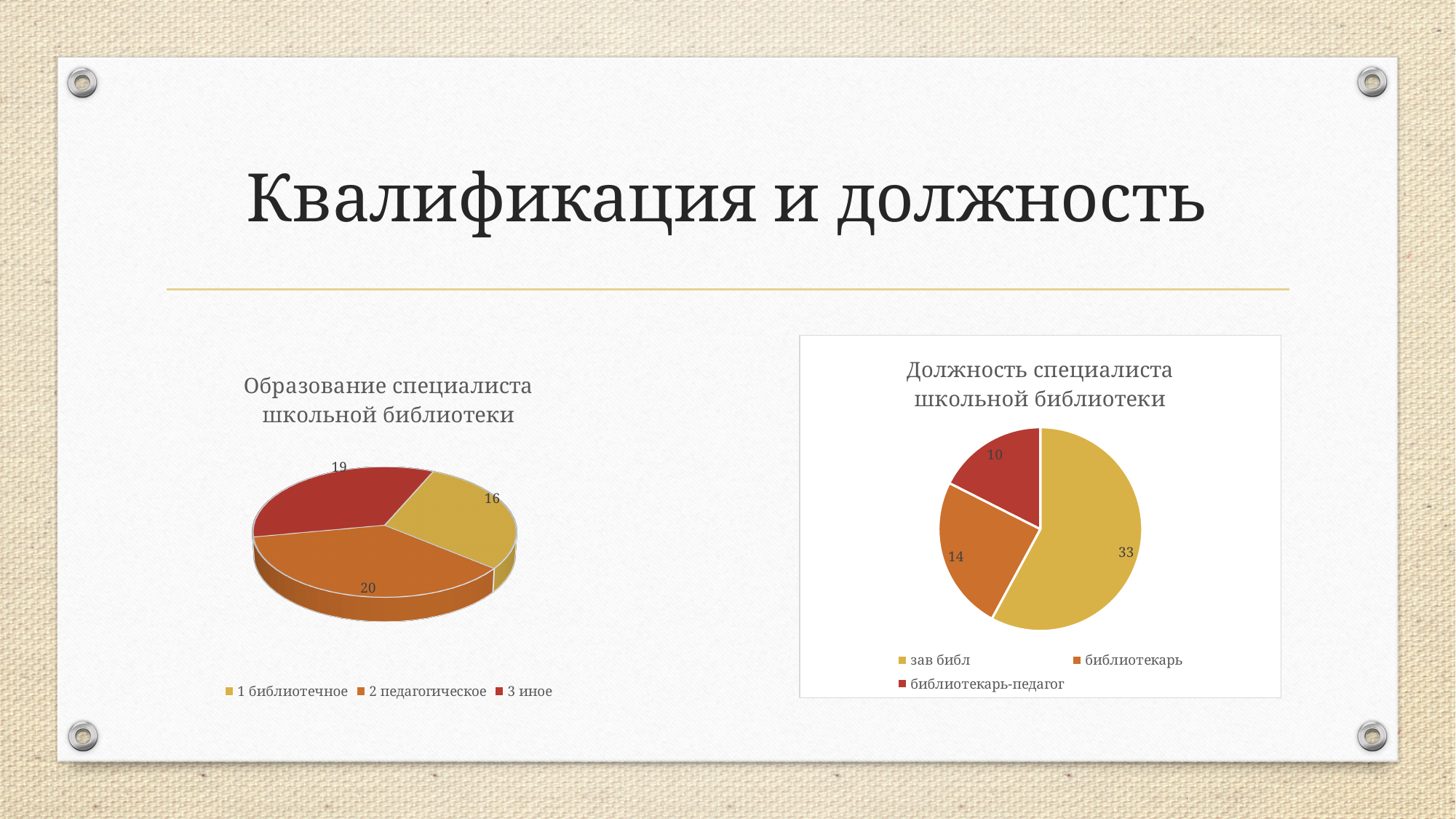
In the chart titled "Образование специалиста школьной библиотеки", what colour is the slice for "3 иное"? Red What type of chart is the one titled "Должность специалиста школьной библиотеки"? Pie chart In the chart titled "Образование специалиста школьной библиотеки", which category has the smallest value? 1 библиотечное In the chart titled "Должность специалиста школьной библиотеки", which is larger: "библиотекарь" or "библиотекарь-педагог"? библиотекарь In the chart titled "Должность специалиста школьной библиотеки", what is the value for "библиотекарь-педагог"? 10 In the chart titled "Должность специалиста школьной библиотеки", what is the value for "зав библ"? 33 In the chart titled "Образование специалиста школьной библиотеки", what is the value for "1 библиотечное"? 16 In the chart titled "Должность специалиста школьной библиотеки", which category has the largest value? зав библ In the chart titled "Образование специалиста школьной библиотеки", what is the difference between the values for "2 педагогическое" and "1 библиотечное"? 4 In the chart titled "Должность специалиста школьной библиотеки", what is the difference between the values for "зав библ" and "библиотекарь"? 19 In the chart titled "Образование специалиста школьной библиотеки", how many slices does the pie have? 3 In the chart titled "Образование специалиста школьной библиотеки", what is the value for "2 педагогическое"? 20